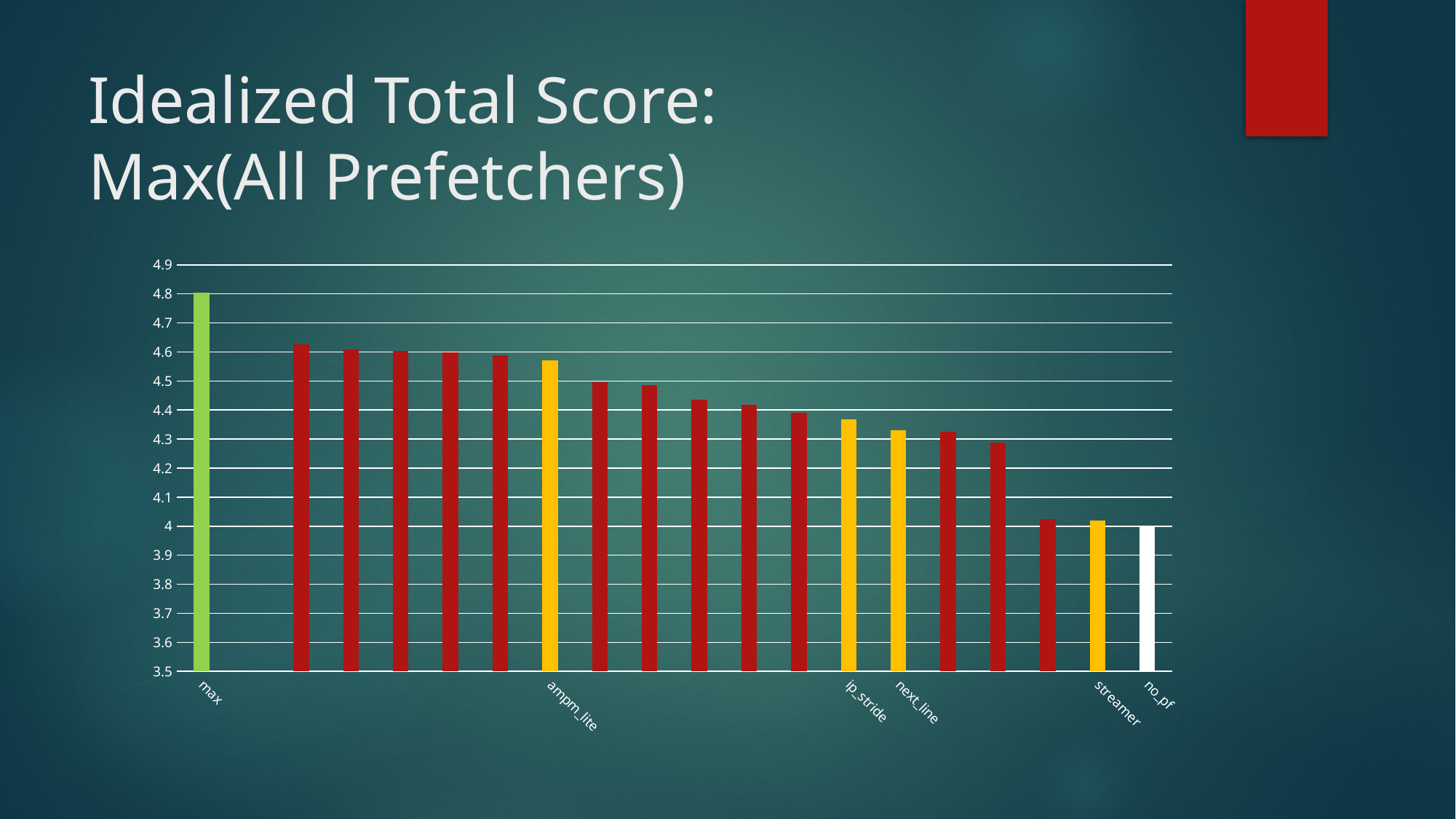
What is the value for no_pf? 4 What is the value for max? 4.8 Which category has the highest value in the chart? max Is the value for ip_stride greater or less than 4.3? greater What kind of chart is shown on the slide? bar chart What is the title of the slide's chart? Idealized Total Score: Max(All Prefetchers) Which is larger, the value for ampm_lite or the value for ip_stride? ampm_lite What colour is the bar for max? green Is the value for ampm_lite greater or less than 4.5? greater Is the value for next_line greater or less than 4.4? less Do the bar values generally rise or fall from left to right along the x axis? fall